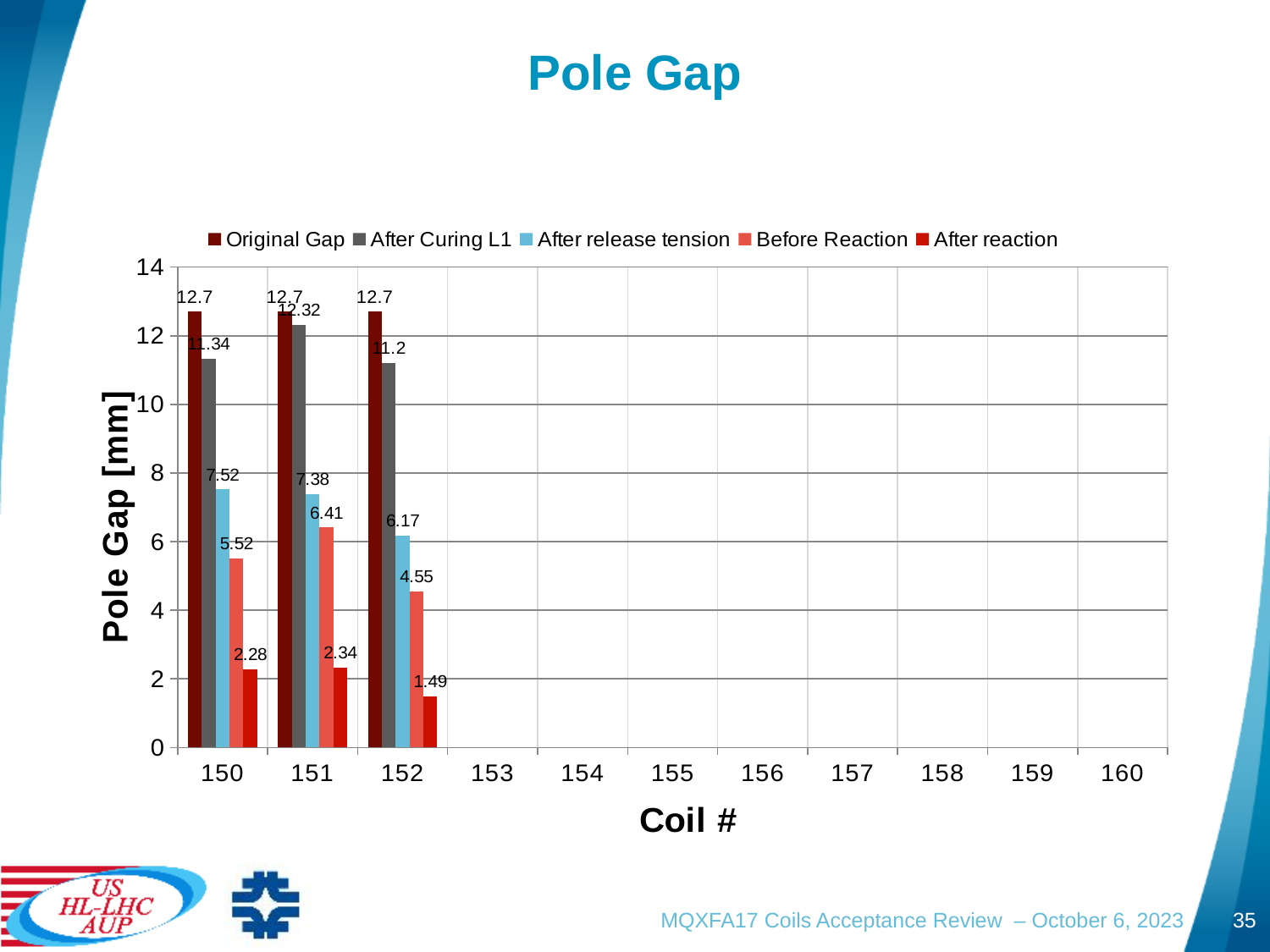
What is the difference between the Original Gap and the After reaction value for coil 150? 10.42 Which coil has the highest After Curing L1 value? 151 What is the After release tension value for coil 152? 6.17 What is the After reaction value for coil 152? 1.49 How many series does the legend list? 5 What type of chart is shown on the slide? bar chart Which coil has the lowest After reaction value? 152 What is the Before Reaction value for coil 151? 6.41 What is the label of the y axis? Pole Gap [mm] Which is larger, the Before Reaction value for coil 150 or for coil 152? coil 150 Is the After release tension value for coil 151 greater or less than 8? less What is the After Curing L1 value for coil 150? 11.34